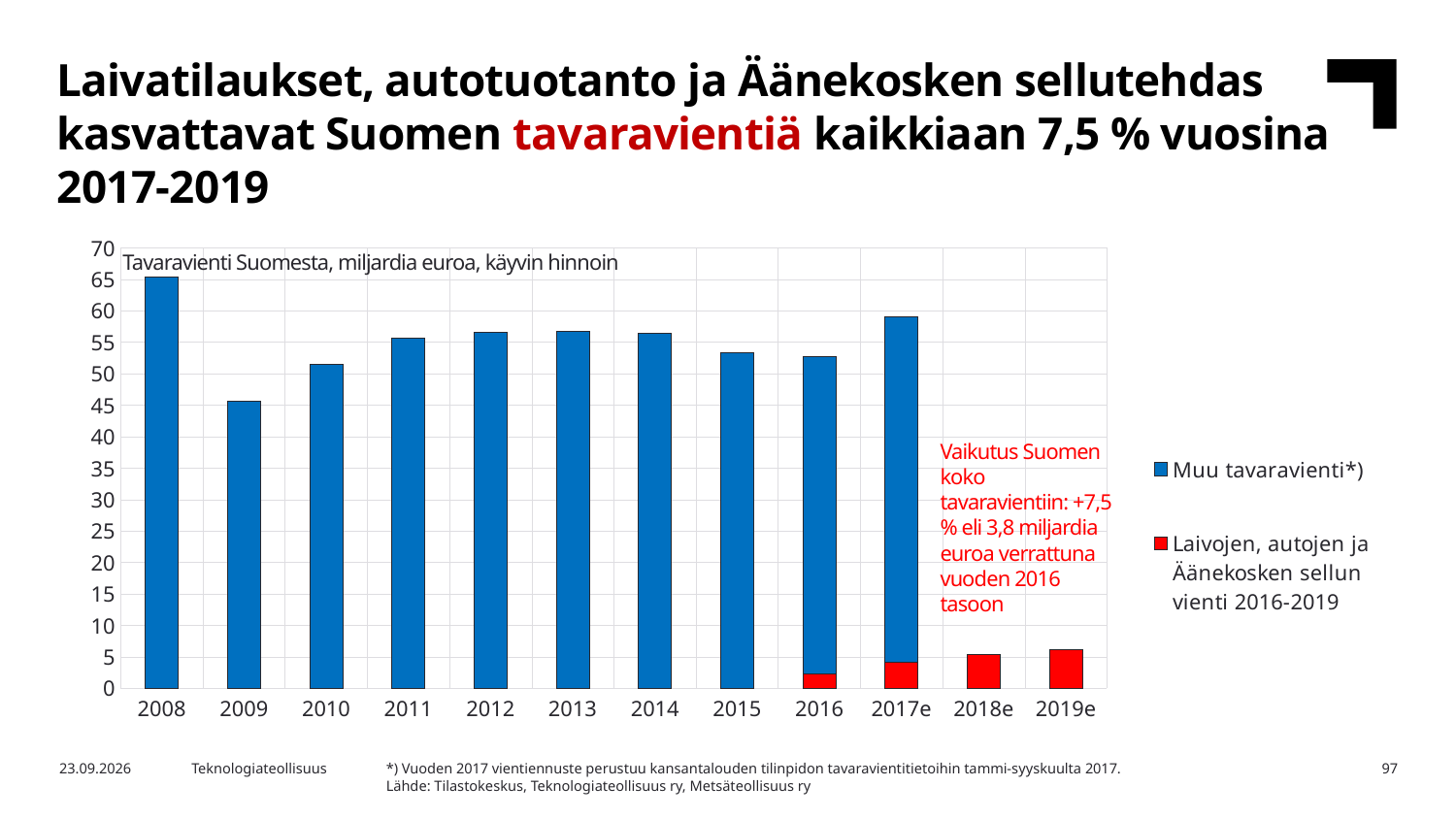
Do the values rise or fall from 2009 to 2013? rise Is the value for 2009 greater or less than 50? less How many years are shown on the x axis? 12 What is the title printed inside the chart area? Tavaravienti Suomesta, miljardia euroa, käyvin hinnoin Is the value for 2008 greater or less than 60? greater Is the total bar for 2017e greater or less than 55? greater What kind of chart is shown on the slide? bar chart Which year has the highest value for Muu tavaravienti*)? 2008 Which is larger, the total bar for 2016 or for 2017e? 2017e Which year has the lowest value for Muu tavaravienti*)? 2009 How many series does the legend list? 2